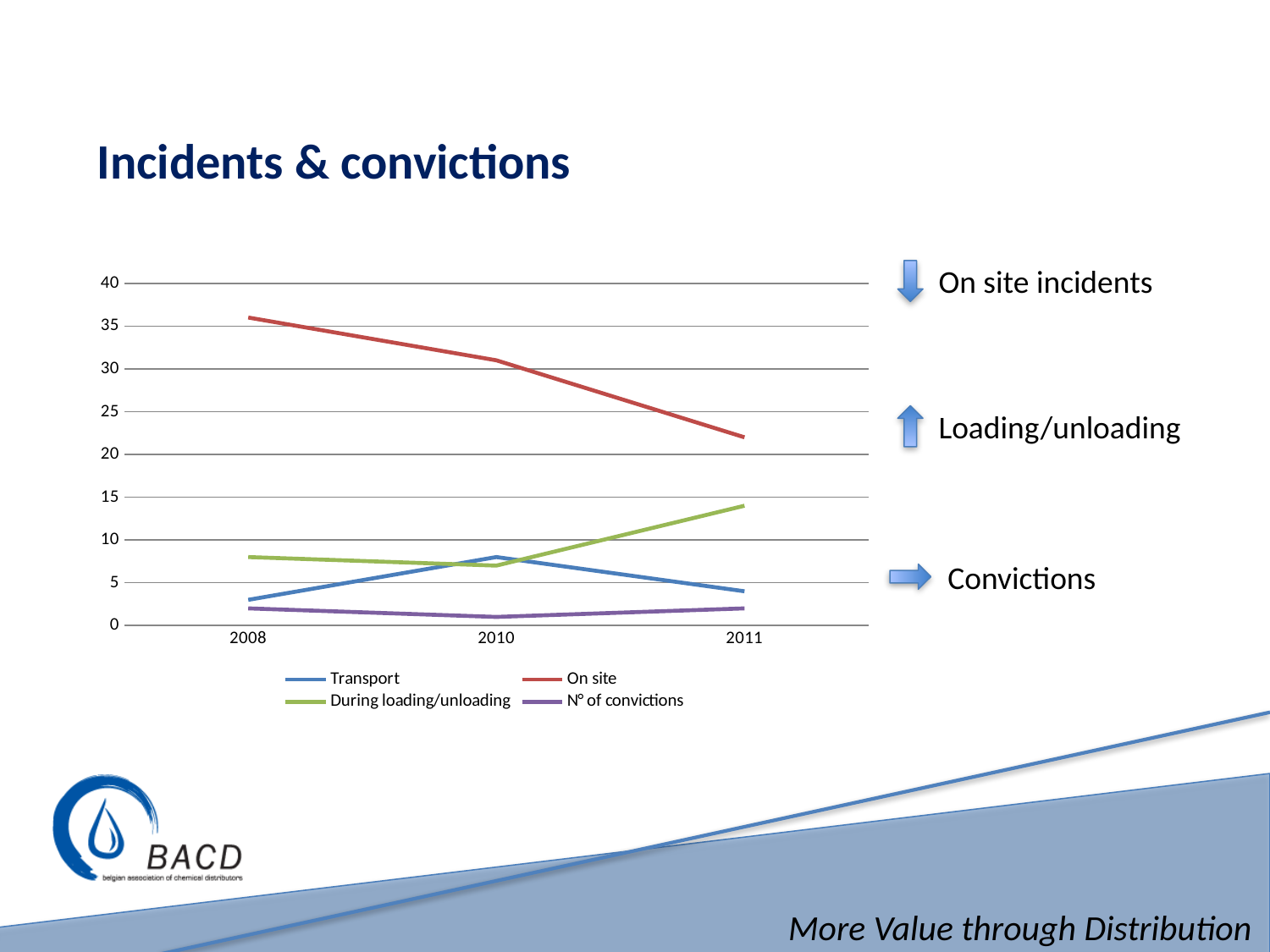
Is the value for On site in 2008 greater or less than 30? greater Is the value for During loading/unloading in 2011 greater or less than 10? greater What is the title of the slide containing the chart? Incidents & convictions Which series has the highest value in 2011? On site How many years are shown on the x axis of the chart? 3 Which series has the lowest value in 2011? N° of convictions How many series does the chart legend list? 4 What kind of chart is shown on the slide? line chart Does the During loading/unloading series rise or fall from 2010 to 2011? rise Is the value for N° of convictions in 2010 greater or less than 5? less In 2011, which is larger: Transport or During loading/unloading? During loading/unloading Does the On site series rise or fall from 2008 to 2011? fall